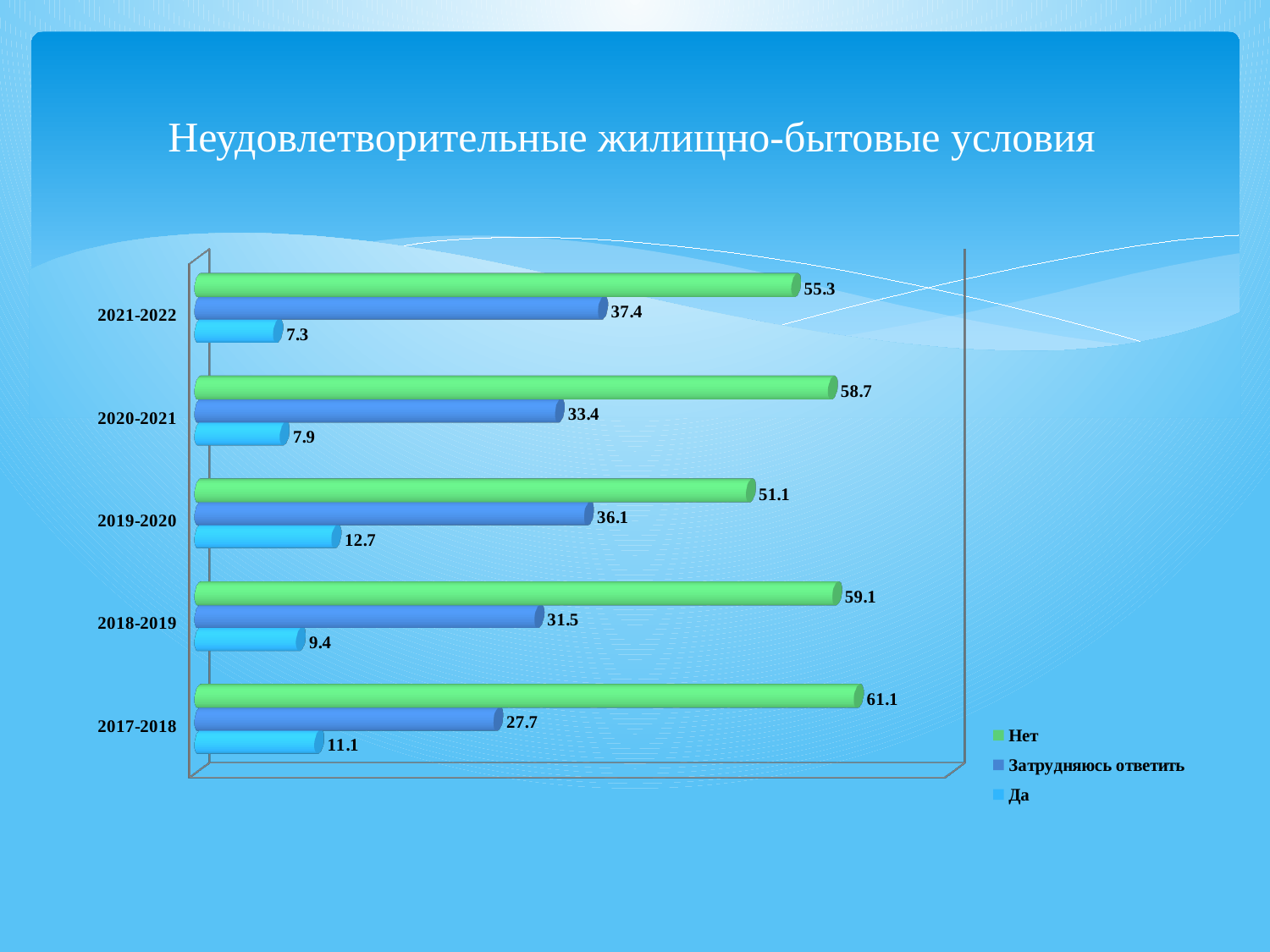
How many year categories are shown on the chart? 5 Which series is shown in green? Нет What is the title of the slide? Неудовлетворительные жилищно-бытовые условия Which is larger: the "Затрудняюсь ответить" value for 2021-2022 or for 2019-2020? 2021-2022 What is the difference between the "Нет" values for 2017-2018 and 2021-2022? 5.8 What is the value for "Затрудняюсь ответить" in 2017-2018? 27.7 What is the value for "Нет" in 2021-2022? 55.3 What kind of chart is shown on the slide? bar chart What is the value for "Да" in 2019-2020? 12.7 In which year is the value for "Да" lowest? 2021-2022 In which year is the value for "Нет" highest? 2017-2018 How many series does the legend list? 3